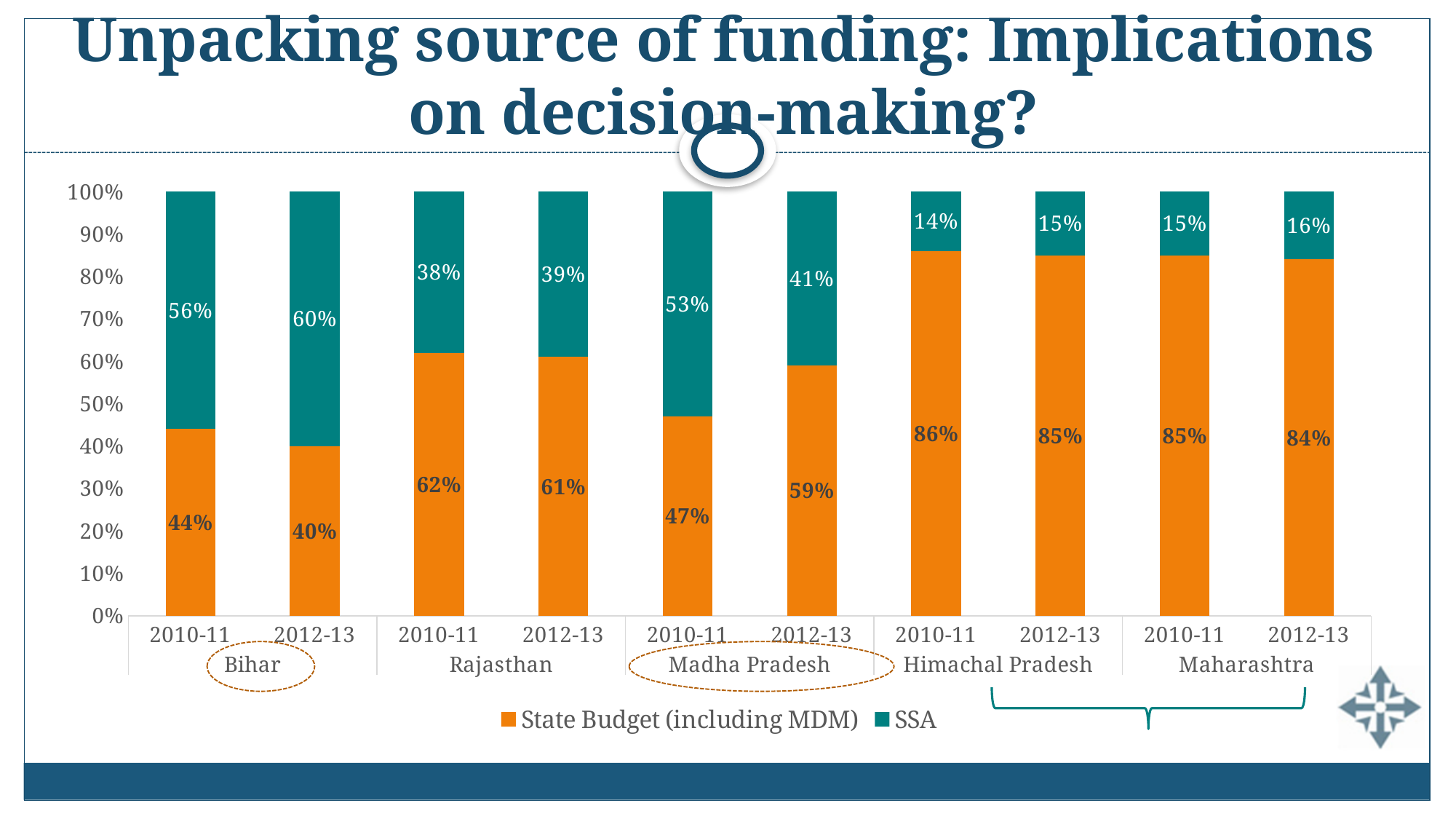
Which is larger: the State Budget (including MDM) share for Rajasthan in 2010-11 or for Madha Pradesh in 2010-11? Rajasthan in 2010-11 What is the SSA share for Madha Pradesh in 2012-13? 41% How many series does the legend list? 2 What kind of chart is shown on the slide? Stacked bar chart Which state and year has the highest SSA share? Bihar, 2012-13 What is the State Budget (including MDM) share for Himachal Pradesh in 2010-11? 86% What is the State Budget (including MDM) share for Bihar in 2010-11? 44% What is the SSA share for Maharashtra in 2012-13? 16% How many states are shown on the x axis? 5 Which colour represents SSA in the chart? Teal Which state and year has the lowest State Budget (including MDM) share? Bihar, 2012-13 What is the difference between the SSA share for Madha Pradesh in 2010-11 and in 2012-13? 12%